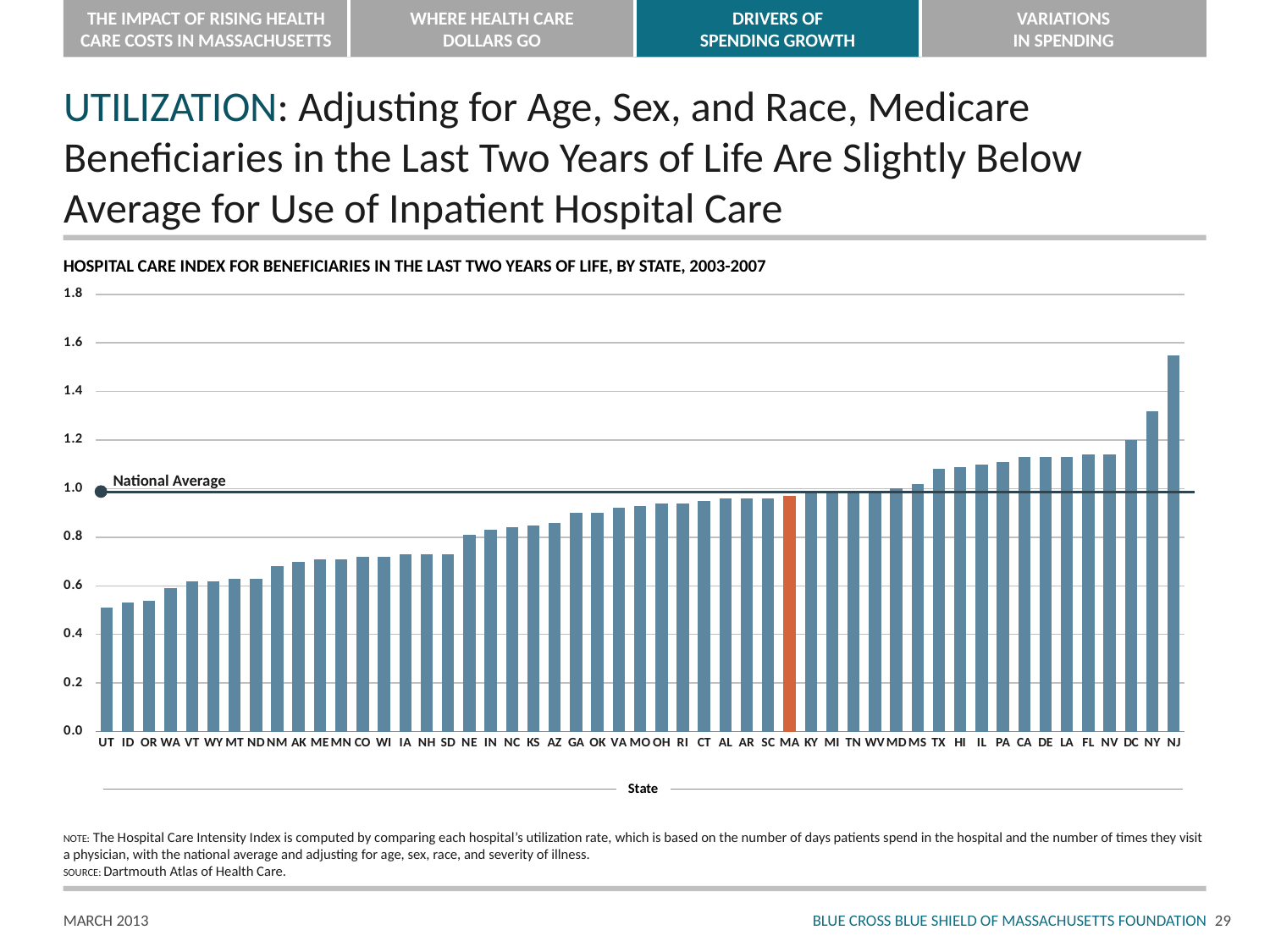
What kind of chart is shown on the slide? bar chart Is the value for MA greater or less than 1.0? less Is the value for UT greater or less than 0.6? less Which has a higher Hospital Care Index value, WA or NE? NE How many states are plotted on the chart? 51 Which state has the lowest Hospital Care Index value? UT Which state's bar is highlighted in orange? MA Which state has the highest Hospital Care Index value? NJ Which has a higher Hospital Care Index value, NJ or DC? NJ Do the bar values rise or fall moving from left to right along the x axis? rise Is the value for NJ greater or less than 1.4? greater